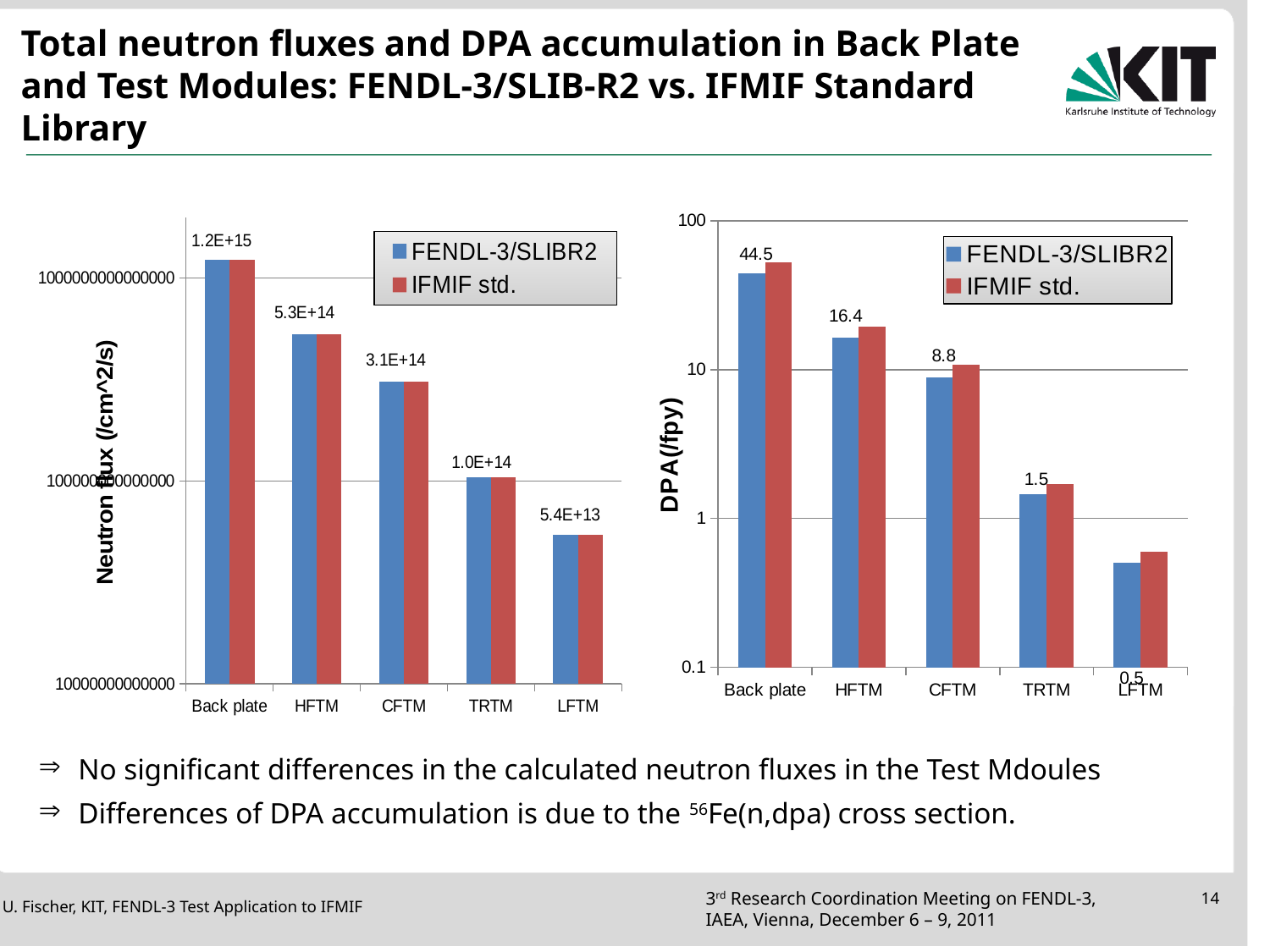
In the right chart (DPA), which category has the highest DPA value? Back plate In the right chart (DPA), what is the labelled DPA value for the HFTM? 16.4 In the left chart (Neutron flux), what is the labelled neutron flux for the LFTM? 5.4E+13 What kind of chart is the left chart (Neutron flux)? Bar chart In the right chart (DPA), is the IFMIF std. value for the LFTM greater or less than 1? less In the right chart (DPA), what is the labelled DPA value for the CFTM? 8.8 In the left chart (Neutron flux), what is the labelled neutron flux for the Back plate? 1.2E+15 How many categories are shown on the x axis of the left chart (Neutron flux)? 5 In the right chart (DPA), what is the difference between the labelled DPA values for the Back plate and the HFTM? 28.1 In the right chart (DPA), for the Back plate, which series has the larger DPA value: FENDL-3/SLIBR2 or IFMIF std.? IFMIF std. In the left chart (Neutron flux), which category has the lowest neutron flux? LFTM How many series does the legend of the right chart (DPA) list? 2